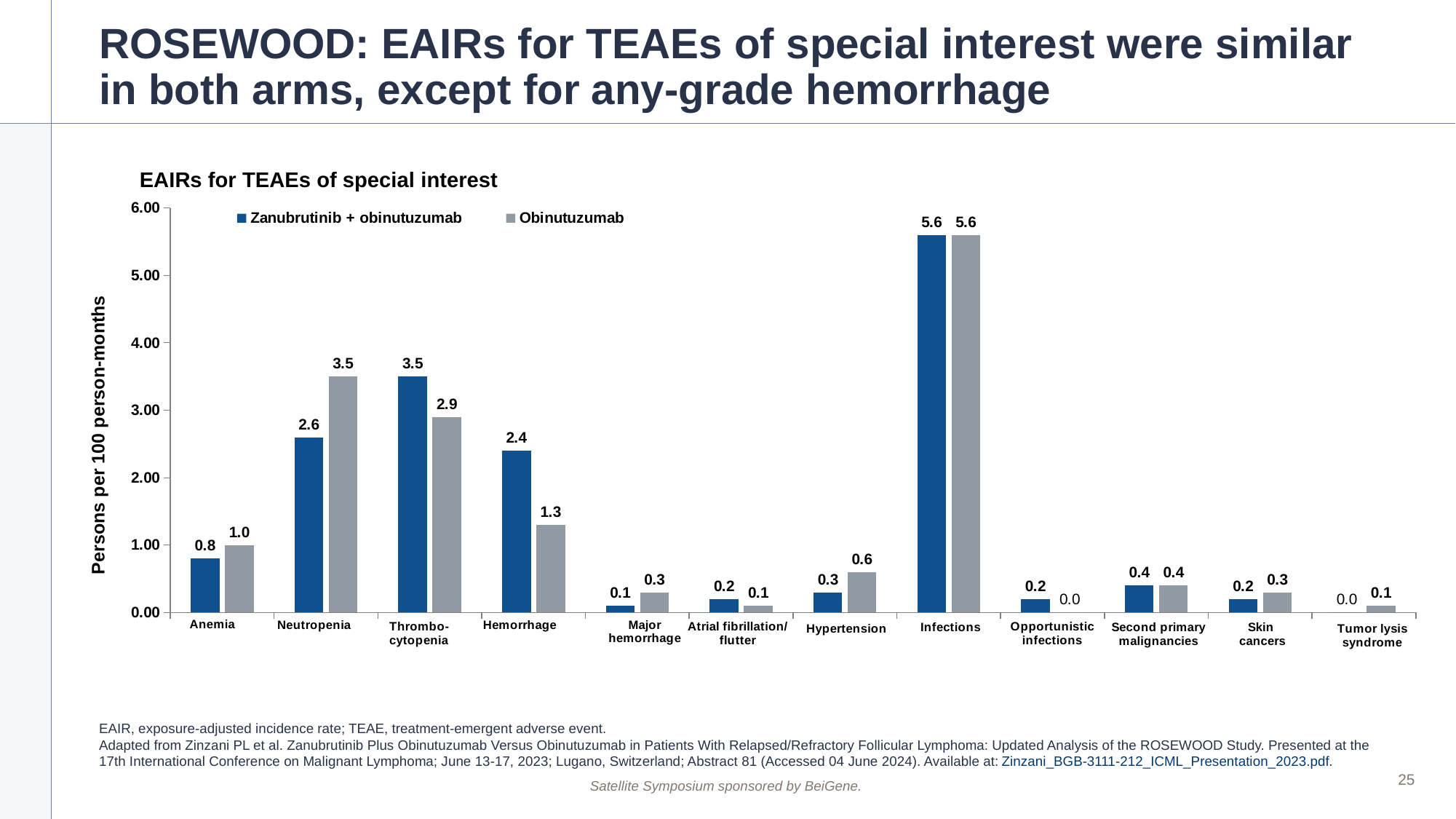
Which category has the lowest EAIR in the Zanubrutinib + obinutuzumab arm? Tumor lysis syndrome What is the difference between the Hemorrhage EAIRs for the Zanubrutinib + obinutuzumab arm and the Obinutuzumab arm? 1.1 For Thrombocytopenia, which arm has the higher EAIR? Zanubrutinib + obinutuzumab How many TEAE categories are shown on the x axis? 12 Is the EAIR for Infections in the Obinutuzumab arm greater or less than 5.00? greater What is the y-axis label of the chart? Persons per 100 person-months How many series does the legend list? 2 What is the EAIR for Hemorrhage in the Zanubrutinib + obinutuzumab arm? 2.4 What is the EAIR for Hypertension in the Obinutuzumab arm? 0.6 Which category has the highest EAIR in the Zanubrutinib + obinutuzumab arm? Infections What kind of chart is shown on the slide? Bar chart What is the EAIR for Neutropenia in the Obinutuzumab arm? 3.5